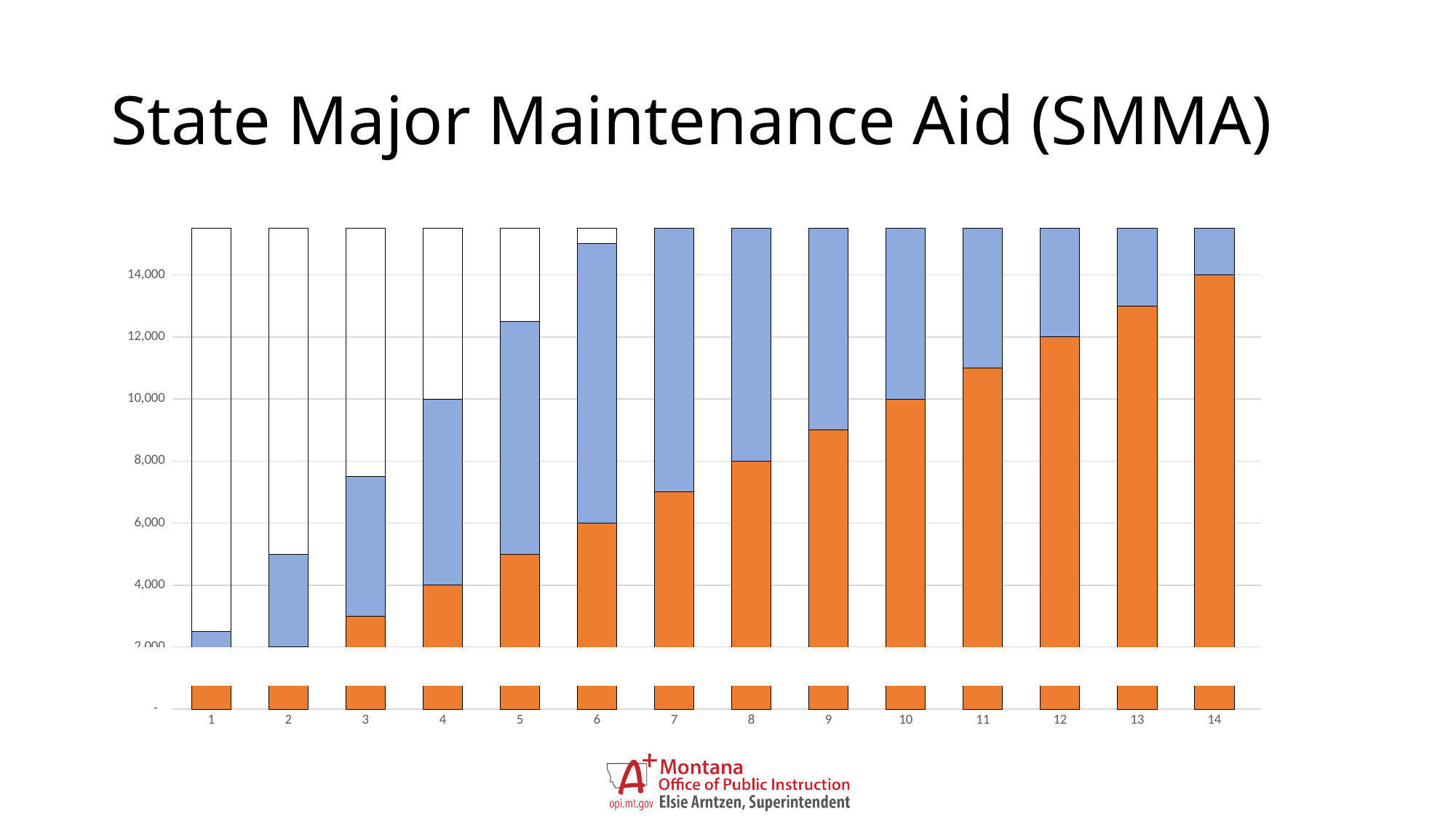
Which is larger, the orange segment for category 1 or for category 13? Category 13 Do the orange segments rise or fall from category 3 to category 14? Rise Which category has the largest orange segment? 14 Is the top of the blue segment for category 3 greater or less than 8,000? less What is the title of the slide containing the chart? State Major Maintenance Aid (SMMA) What is the value of the orange segment for category 4? 4,000 Is the orange segment for category 7 greater or less than 6,000? greater What is the value of the orange segment for category 14? 14,000 How many categories are shown along the x axis? 14 What kind of chart is shown on the slide? Stacked bar chart Which category has the smallest orange segment? 1 What is the value of the orange segment for category 8? 8,000